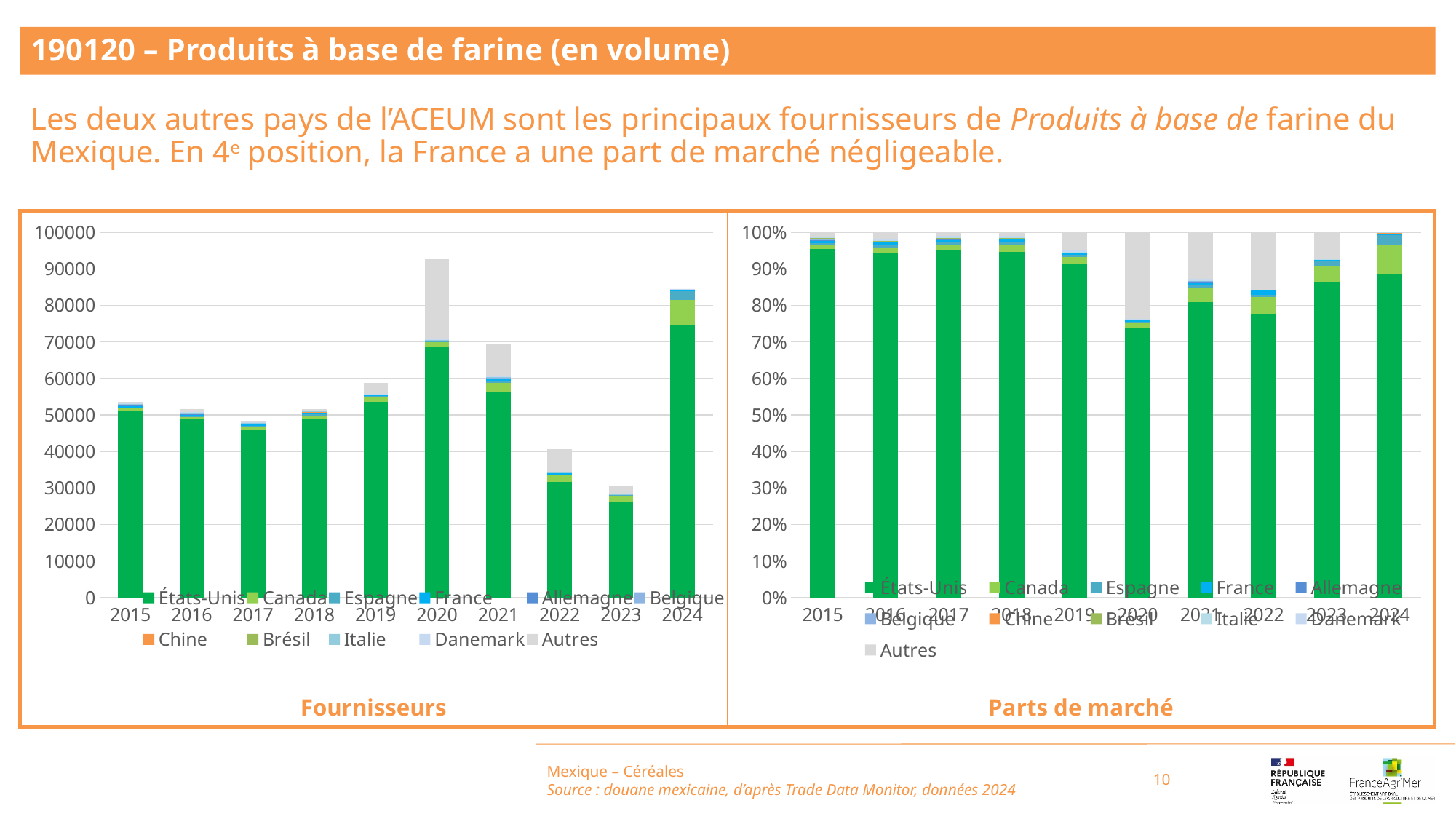
How many years are shown on the x axis of the 'Fournisseurs' chart? 10 In the 'Fournisseurs' chart, is the total for 2020 greater or less than 90000? greater In the 'Fournisseurs' chart, is the total for 2023 greater or less than 40000? less What is the title of the chart on the right of the slide? Parts de marché In the 'Parts de marché' chart, in which year is the share of États-Unis the lowest? 2020 In the 'Fournisseurs' chart, which year has the lowest total bar? 2023 In the 'Fournisseurs' chart, do the total bars rise or fall from 2020 to 2023? fall In the 'Parts de marché' chart, is the share of États-Unis in 2020 greater or less than 80%? less In the 'Fournisseurs' chart, which year has the highest total bar? 2020 In the 'Fournisseurs' chart, is the total bar for 2021 larger or smaller than the total bar for 2019? larger What kind of chart is the 'Fournisseurs' chart on the left? stacked bar chart How many series does the legend of the 'Parts de marché' chart list? 11